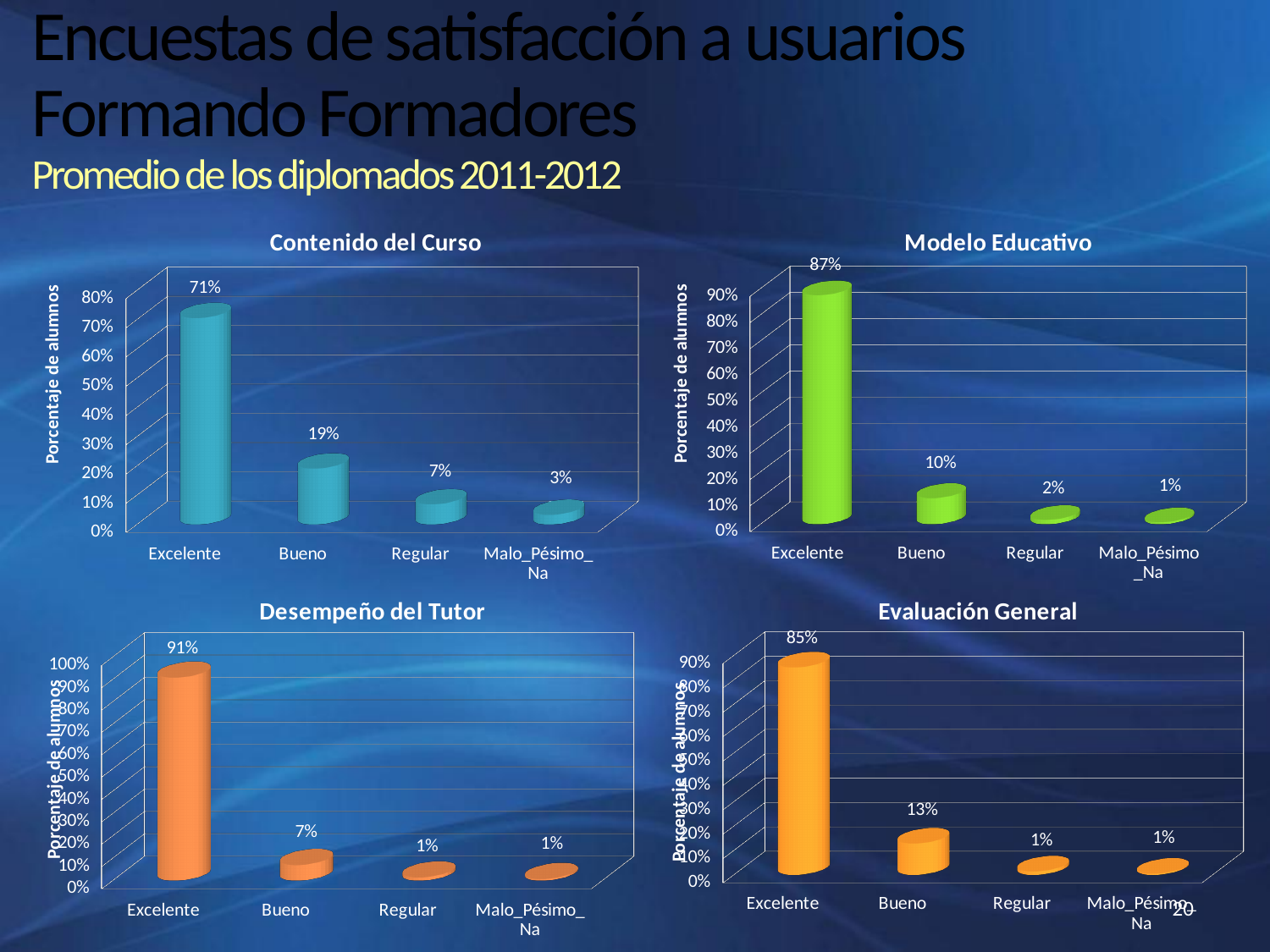
What kind of chart is 'Evaluación General'? Bar chart In the 'Desempeño del Tutor' chart, do the values rise or fall from Excelente to Malo_Pésimo_Na? Fall In the 'Modelo Educativo' chart, which category has the highest value? Excelente How many categories does the 'Desempeño del Tutor' chart show? 4 In the 'Contenido del Curso' chart, what is the difference between Excelente and Bueno? 52% In the 'Contenido del Curso' chart, which category has the lowest value? Malo_Pésimo_Na In the 'Modelo Educativo' chart, what is the value for Bueno? 10% In the 'Evaluación General' chart, what is the value for Bueno? 13% In the 'Desempeño del Tutor' chart, what is the value for Excelente? 91% In the 'Contenido del Curso' chart, what is the value for Excelente? 71% In the 'Modelo Educativo' chart, which is larger, Regular or Malo_Pésimo_Na? Regular In the 'Evaluación General' chart, what is the difference between Excelente and Bueno? 72%